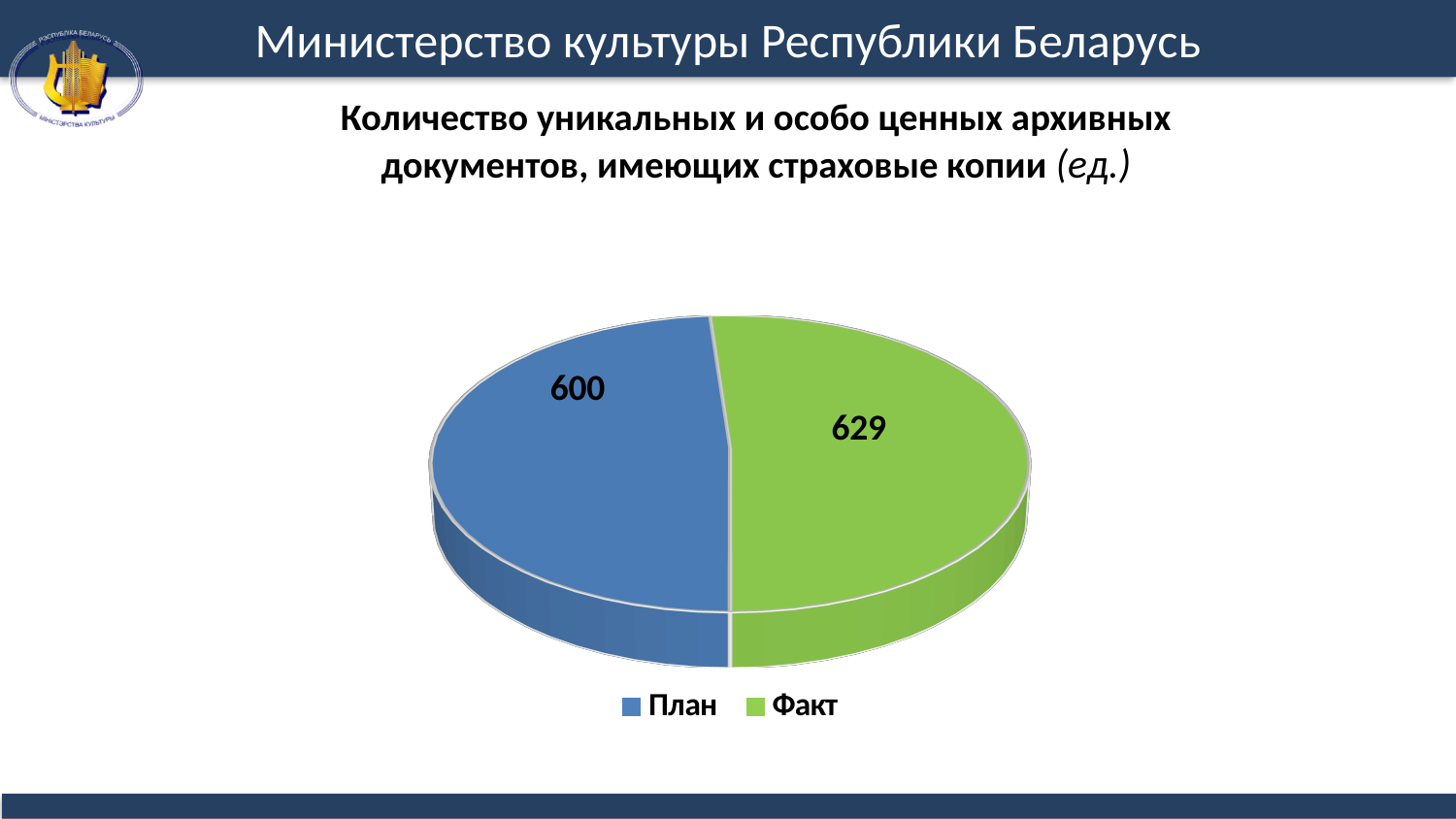
How many slices does the pie chart have? 2 What colour is the Факт slice? green What is the value of the План slice? 600 What is the difference between the Факт value and the План value? 29 Which slice has the larger value, План or Факт? Факт Is the value for Факт larger or smaller than the value for План? larger What is the total of the two slices in the pie chart? 1229 How many entries does the legend list? 2 Which slice has the smaller value? План What unit is given in parentheses in the chart title? ед. What is the value of the Факт slice? 629 What type of chart is shown on the slide? pie chart